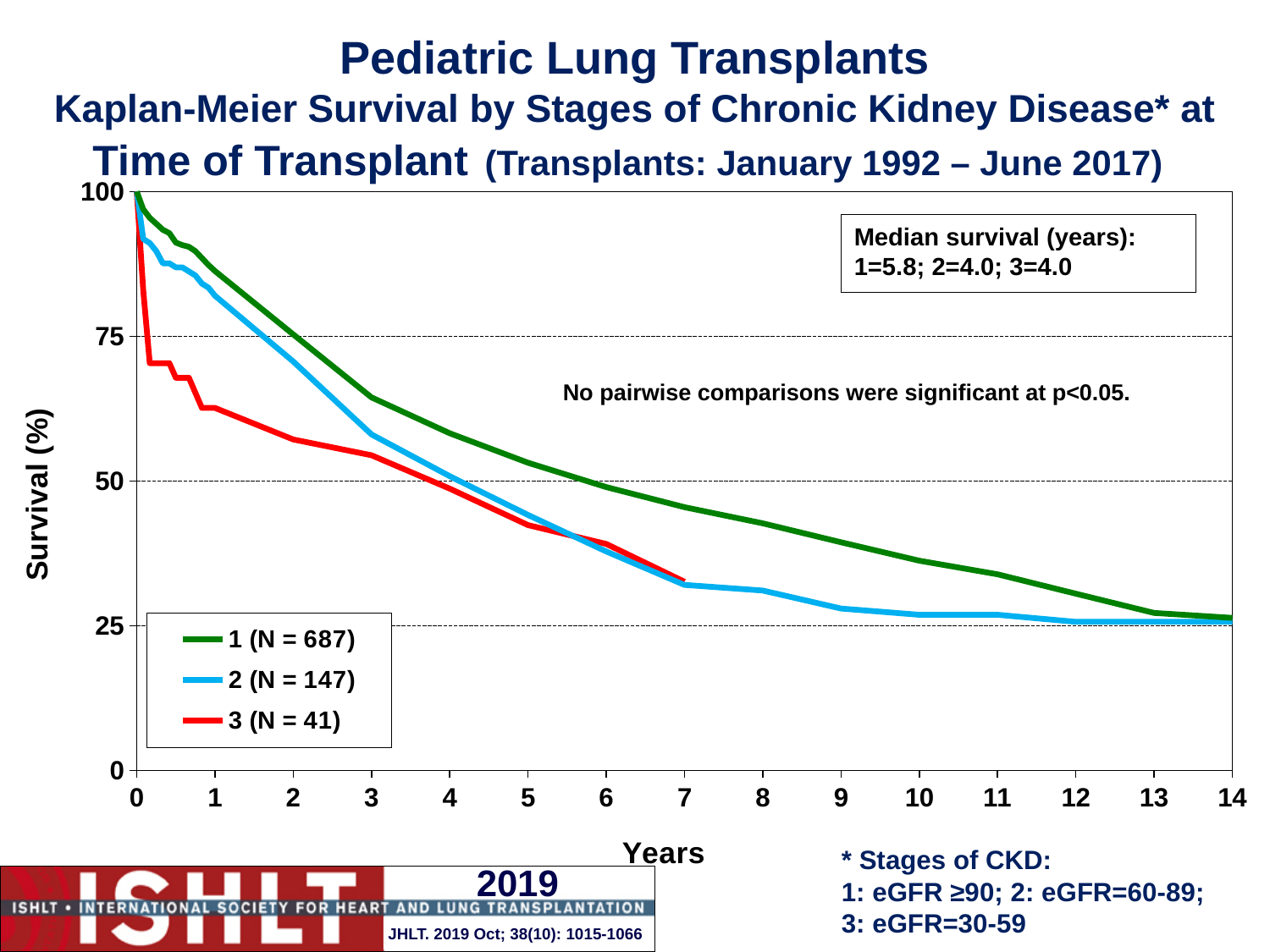
What is the median survival in years for CKD stage 1? 5.8 How many series does the legend list? 3 Is the survival value for stage 1 at year 3 greater or less than 50? greater Do the survival curves rise or fall as years increase? fall What is the label of the y axis? Survival (%) Is the survival value for stage 3 at year 5 greater or less than 50? less At year 1, which series has higher survival, stage 1 or stage 3? stage 1 What kind of chart is shown on the slide? line chart What is the N for the stage 2 series in the legend? 147 Is the survival value for stage 2 at year 2 greater or less than 75? less What is the median survival in years for CKD stage 3? 4.0 Which CKD stage has the highest median survival? 1